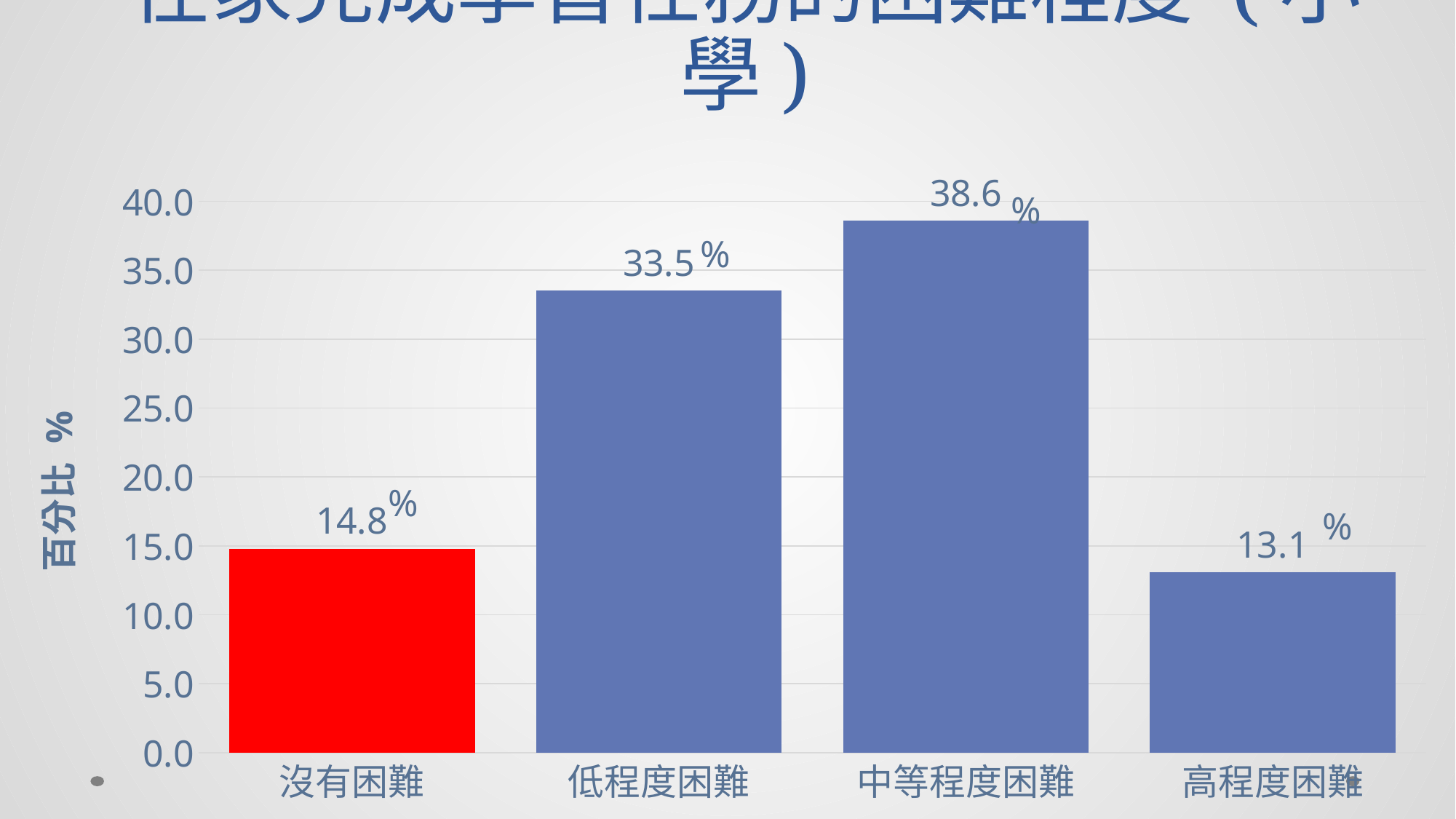
What is the value for 高程度困難? 13.1% Which is larger, the value for 低程度困難 or the value for 高程度困難? 低程度困難 What is the value for 中等程度困難? 38.6% What kind of chart is shown on the slide? Bar chart What is the value for 沒有困難? 14.8% Which bar is coloured red? 沒有困難 Which category has the lowest value? 高程度困難 Which category has the highest value? 中等程度困難 What is the difference between the values for 沒有困難 and 高程度困難? 1.7% What is the difference between the values for 中等程度困難 and 低程度困難? 5.1% How many categories are shown on the x axis? 4 What is the value for 低程度困難? 33.5%